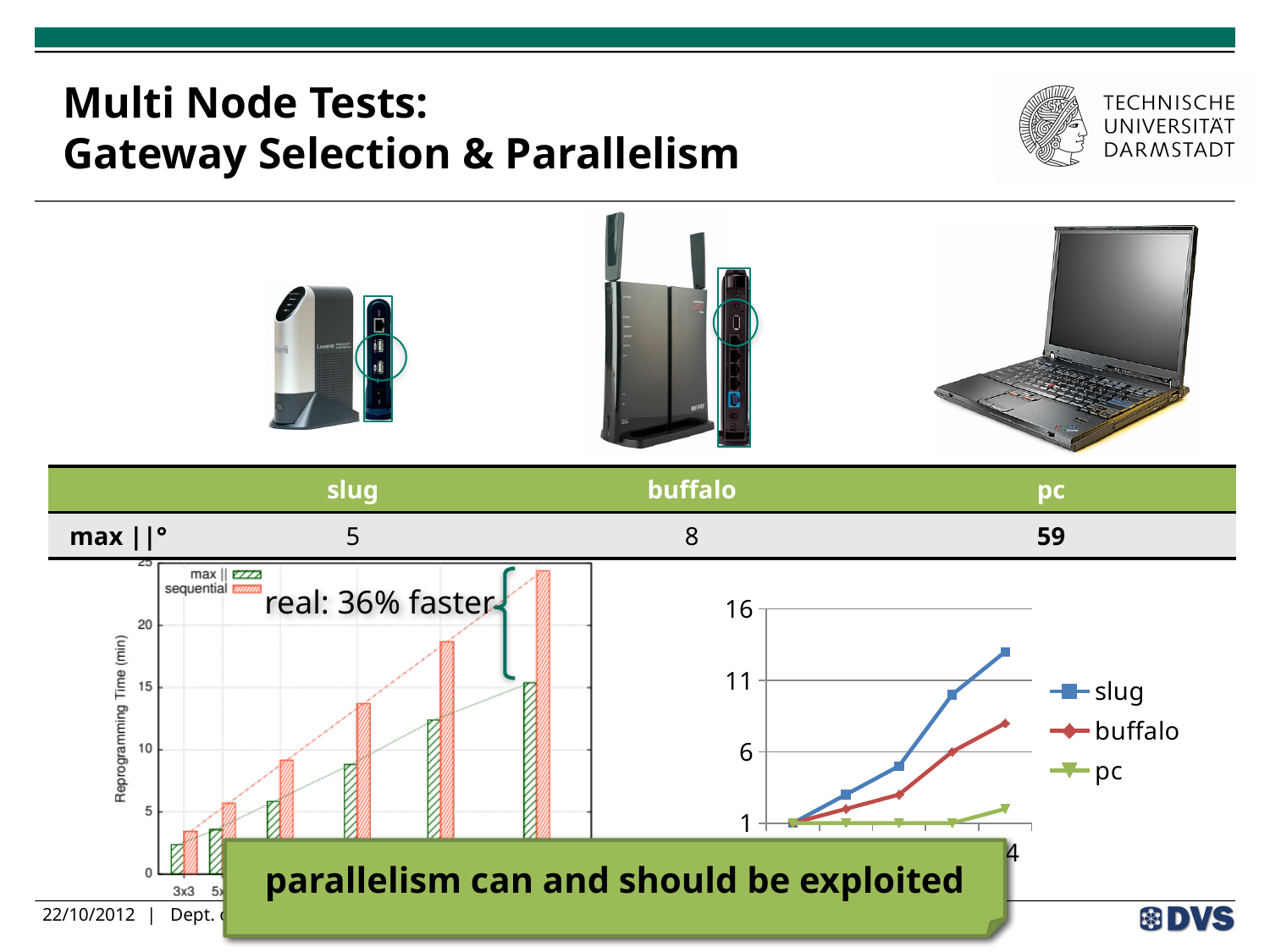
In the left-hand bar chart, is the tallest sequential bar greater or less than 20? greater What kind of chart is the chart on the left of the slide? bar chart In the right-hand line chart, is the final value of the slug series greater or less than 11? greater How many series does the legend of the right-hand chart list? 3 In the right-hand line chart, which series stays lowest across the x axis? pc In the right-hand line chart, which series reaches the highest value at the rightmost point? slug How many series does the legend of the left-hand bar chart list? 2 In the left-hand bar chart, which series has the taller bars, max || or sequential? sequential What kind of chart is the chart on the right of the slide? line chart In the right-hand line chart, is the final value of the buffalo series greater or less than 11? less In the right-hand line chart, does the slug series rise or fall along the x axis? rise What is the y-axis label of the left-hand bar chart? Reprogramming Time (min)